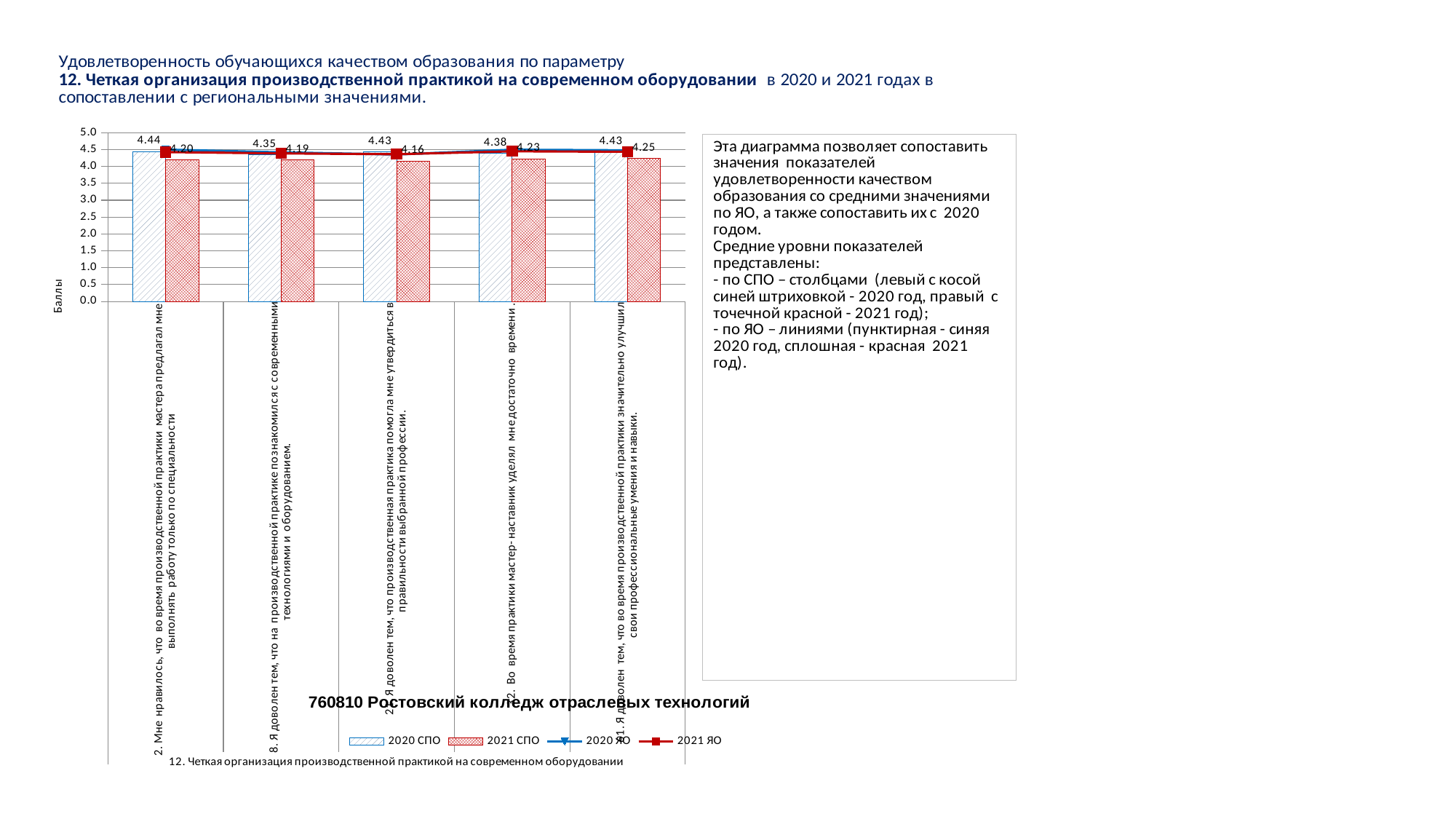
What is the 2021 СПО value for item 9 ("Я доволен тем, что производственная практика помогла мне утвердиться в правильности выбранной профессии")? 4.16 What is the difference between the 2020 СПО and 2021 СПО values for item 31? 0.18 How many series does the chart legend list? 4 What is the 2020 СПО value for item 2 ("Мне нравилось, что во время производственной практики мастера предлагал мне выполнять работу только по специальности")? 4.44 How many categories (items) are shown on the x axis of the chart? 5 Which item has the lowest 2021 СПО value? 21. Я доволен тем, что производственная практика помогла мне утвердиться в правильности выбранной профессии What kind of chart is used for the СПО values? bar chart What is the difference between the 2020 СПО and 2021 СПО values for item 2? 0.24 For item 8, which is larger: the 2020 СПО value or the 2021 СПО value? 2020 СПО What is the 2021 СПО value for item 31 ("Я доволен тем, что во время производственной практики значительно улучшил свои профессиональные умения и навыки")? 4.25 What is the title of the vertical axis of the chart? Баллы